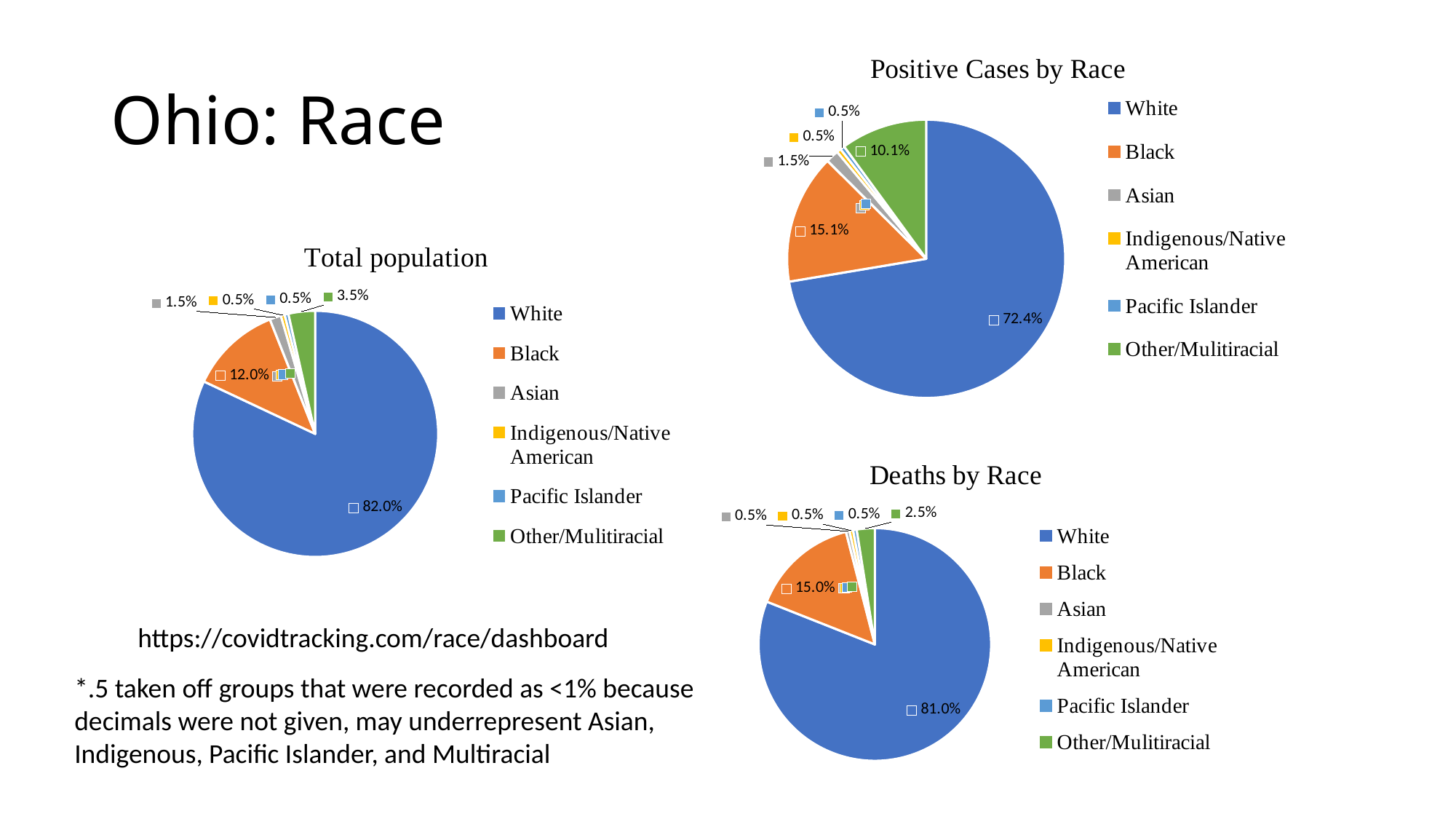
In the "Total population" pie chart, which category has the second-largest slice? Black In the "Positive Cases by Race" pie chart, what share is labelled for Other/Mulitiracial? 10.1% In the "Total population" pie chart, what share is labelled for Asian? 1.5% What kind of chart is "Positive Cases by Race"? Pie chart In the "Deaths by Race" pie chart, which category has the largest slice? White In the "Positive Cases by Race" pie chart, what share is labelled for Black? 15.1% In the "Positive Cases by Race" pie chart, what is the difference between the White share and the Black share? 57.3% How many categories does the legend of the "Deaths by Race" pie chart list? 6 In the "Total population" pie chart, what share is labelled for White? 82.0% Is the Black share larger in the "Positive Cases by Race" chart or in the "Total population" chart? Positive Cases by Race How many pie charts are shown on the slide? 3 In the "Deaths by Race" pie chart, what share is labelled for Other/Mulitiracial? 2.5%